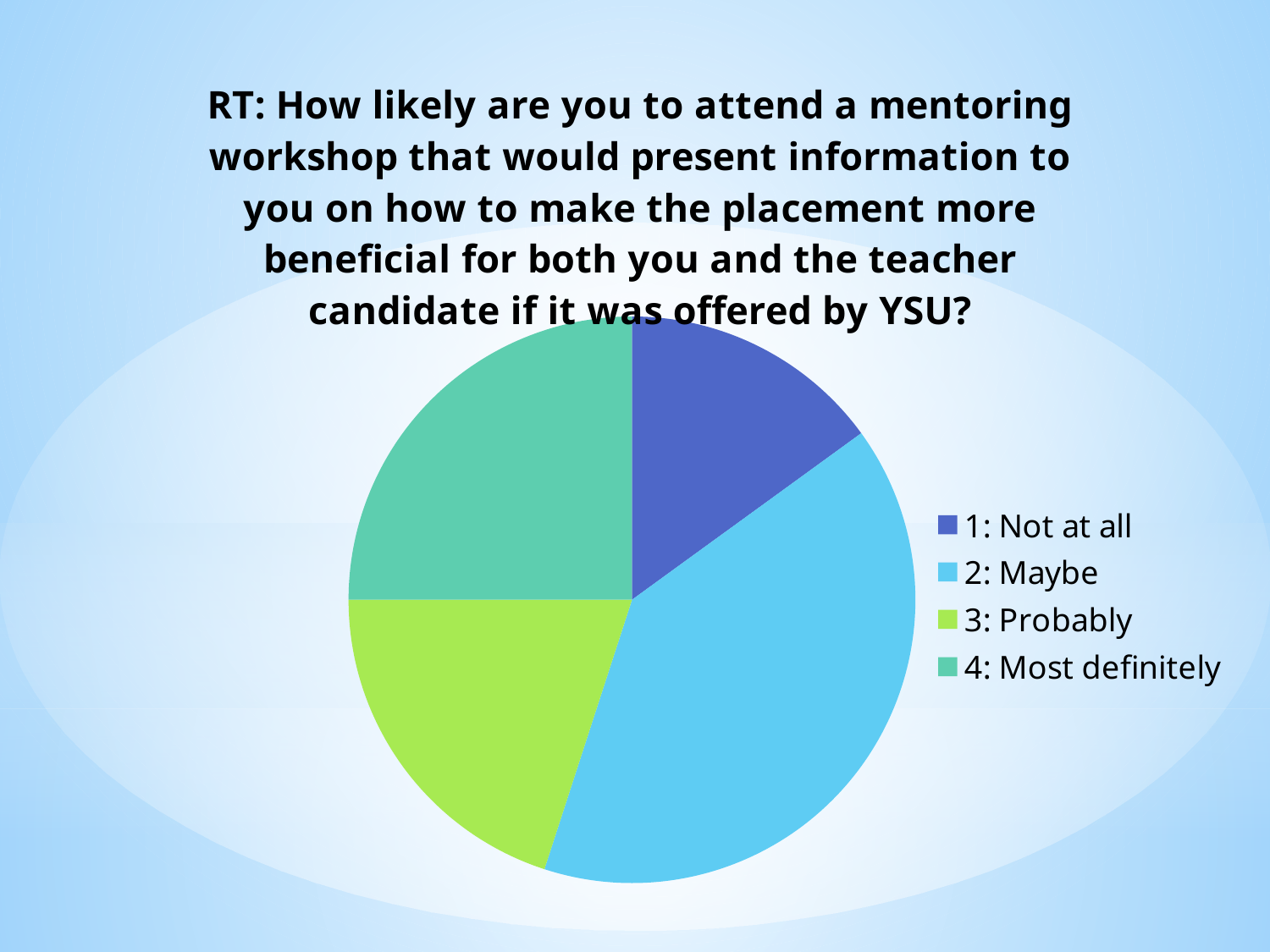
Which legend entry is shown in light green? 3: Probably Which slice is larger, "2: Maybe" or "1: Not at all"? 2: Maybe Which legend entry is shown in dark blue? 1: Not at all Which slice is larger, "4: Most definitely" or "1: Not at all"? 4: Most definitely What kind of chart is shown on the slide? pie chart How many slices does the pie chart have? 4 Which response category has the largest slice of the pie? 2: Maybe Which response category has the smallest slice of the pie? 1: Not at all How many entries does the legend list? 4 Which slice is larger, "2: Maybe" or "3: Probably"? 2: Maybe